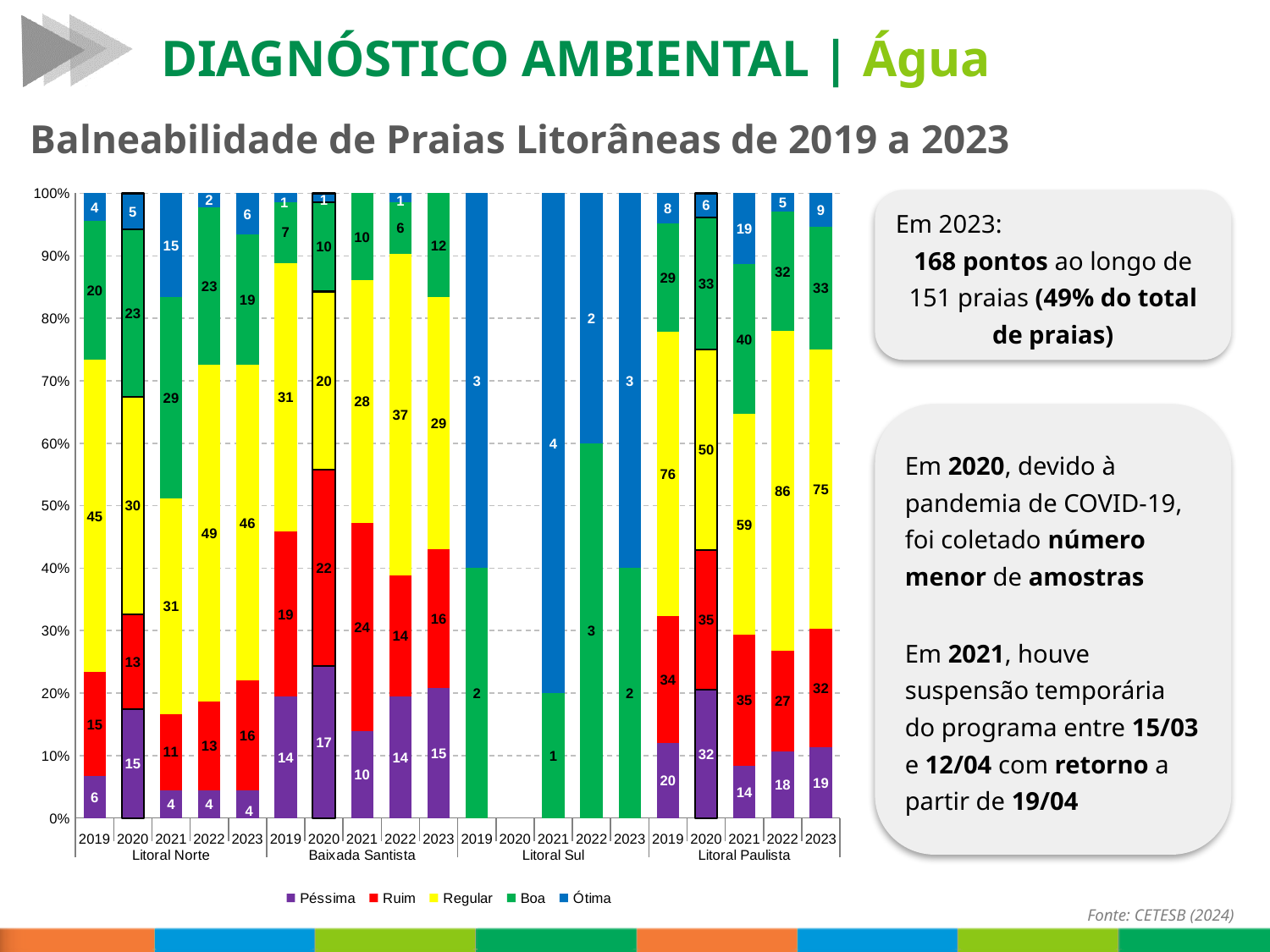
What kind of chart is shown on the slide? Stacked bar chart How many series does the legend list? 5 Within Litoral Paulista, which year has the highest Regular value? 2022 What is the Ótima value for Litoral Paulista in 2021? 19 What is the Péssima value for Litoral Norte in 2020? 15 What is the Regular value for Litoral Paulista in 2022? 86 What is the total of all segments in the Litoral Paulista 2023 bar? 168 Which year has the larger Boa value for Litoral Norte, 2021 or 2022? 2021 What is the difference between the Regular values for Litoral Paulista in 2022 and 2023? 11 What is the Ruim value for Baixada Santista in 2020? 22 How many regional groups are shown along the x axis? 4 What is the Boa value for Litoral Sul in 2022? 3